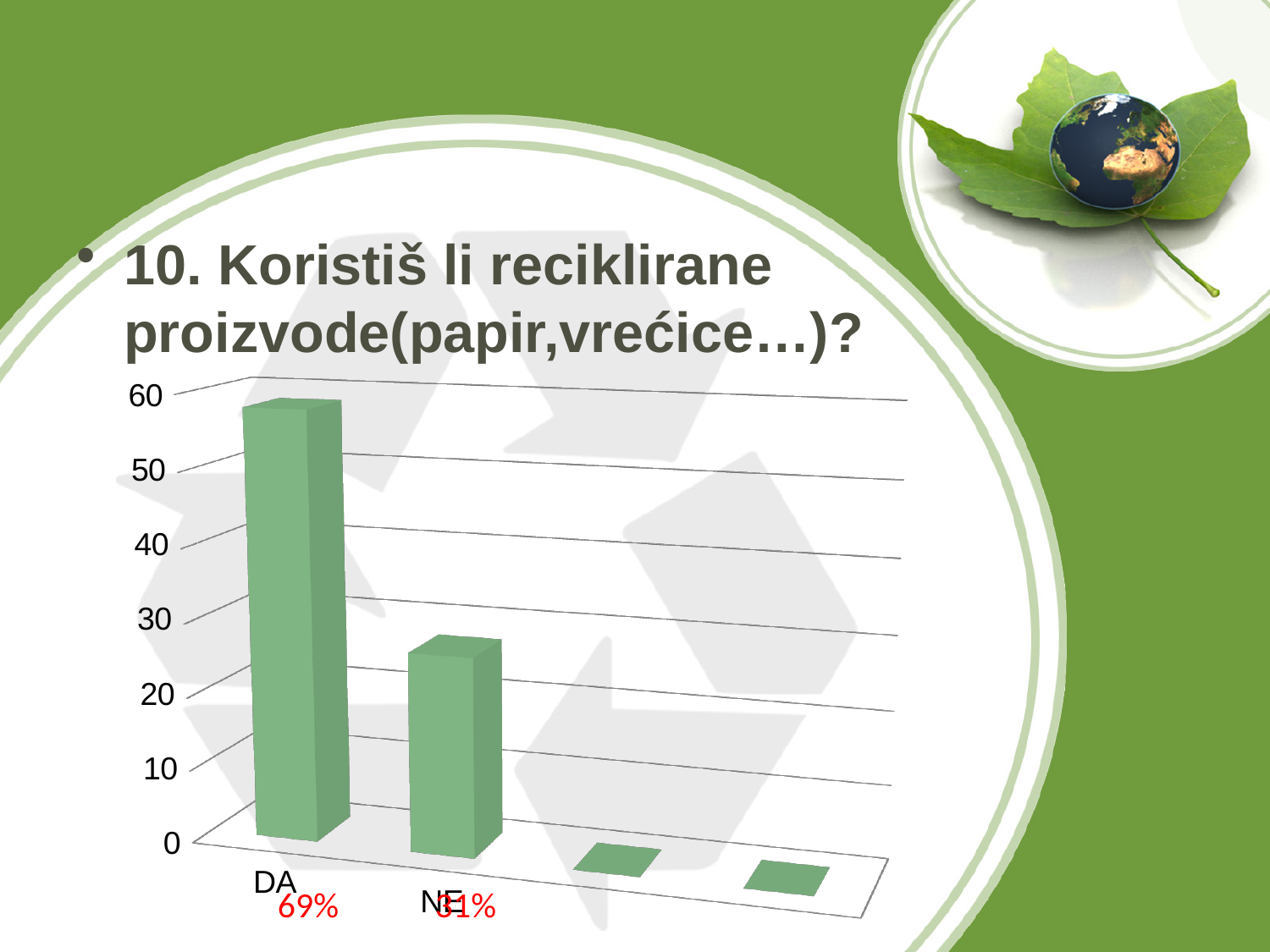
Is the bar for DA taller or shorter than the bar for NE? taller Is the value for NE greater or less than 30? less What is the highest tick value shown on the vertical axis? 60 Which of the two labelled categories, DA or NE, has the lower bar? NE Which category has the highest bar, DA or NE? DA What kind of chart is shown on the slide? bar chart How many category labels appear on the x axis of the chart? 2 What colour are the bars in the chart? green Is the value for DA greater or less than 50? greater Is the value for NE greater or less than 20? greater